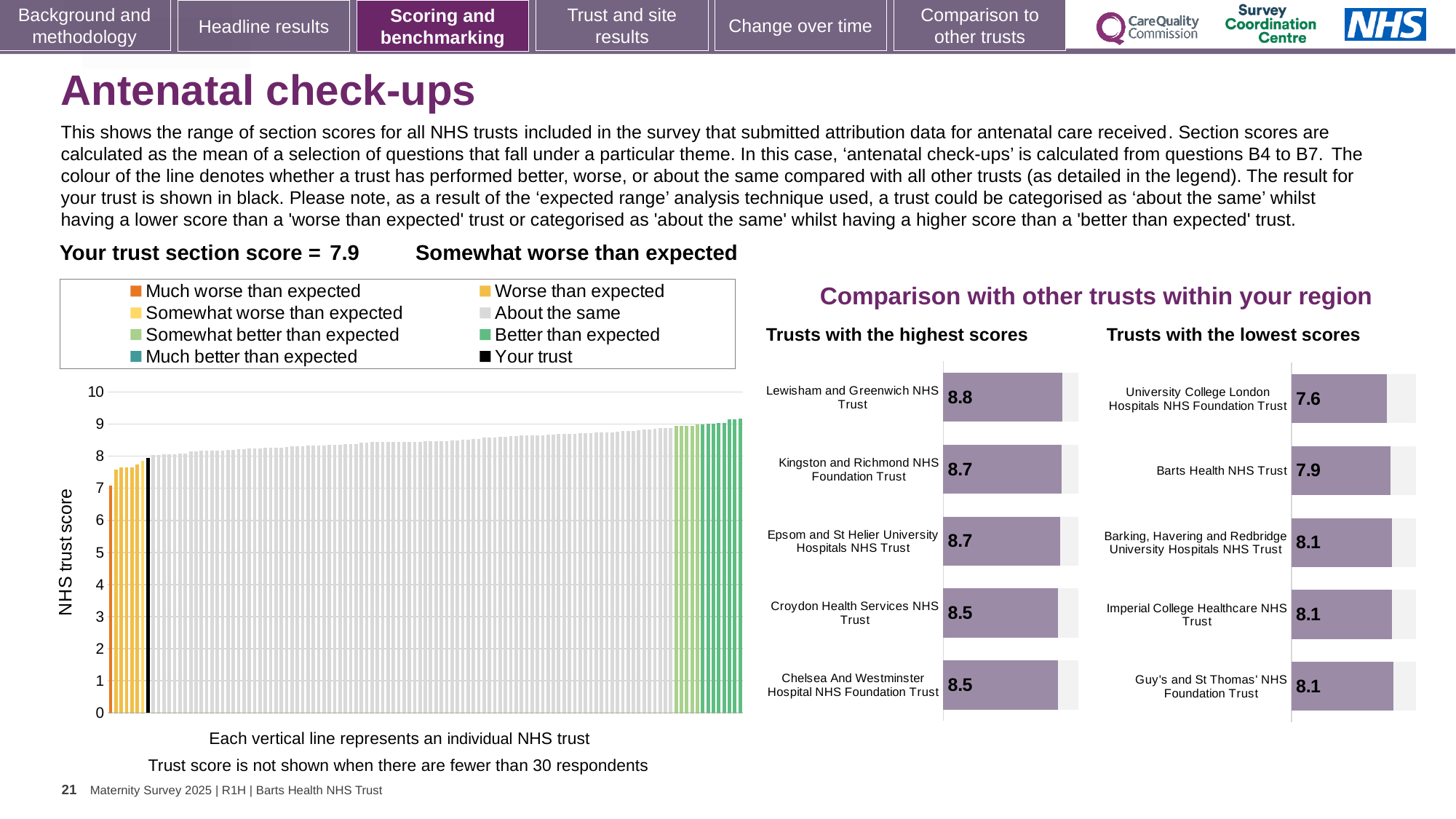
In the 'Trusts with the lowest scores' chart, what is the difference between the scores of Barts Health NHS Trust and University College London Hospitals NHS Foundation Trust? 0.3 In the 'Trusts with the lowest scores' chart, what is the score for Barts Health NHS Trust? 7.9 What kind of chart is the 'NHS trust score' chart on the left of the slide? Bar chart How many trusts are shown in the 'Trusts with the highest scores' chart? 5 In the 'NHS trust score' chart on the left, do the bar values rise or fall from left to right? Rise In the 'Trusts with the lowest scores' chart, which trust has the lowest score? University College London Hospitals NHS Foundation Trust In the 'Trusts with the lowest scores' chart, what is the score for University College London Hospitals NHS Foundation Trust? 7.6 How many entries does the legend above the 'NHS trust score' chart list? 8 In the 'Trusts with the highest scores' chart, what is the score for Lewisham and Greenwich NHS Trust? 8.8 In the 'Trusts with the highest scores' chart, which trust has the highest score? Lewisham and Greenwich NHS Trust In the 'Trusts with the lowest scores' chart, which has the higher score: Barts Health NHS Trust or Imperial College Healthcare NHS Trust? Imperial College Healthcare NHS Trust In the 'Trusts with the highest scores' chart, what is the difference between the scores of Lewisham and Greenwich NHS Trust and Croydon Health Services NHS Trust? 0.3